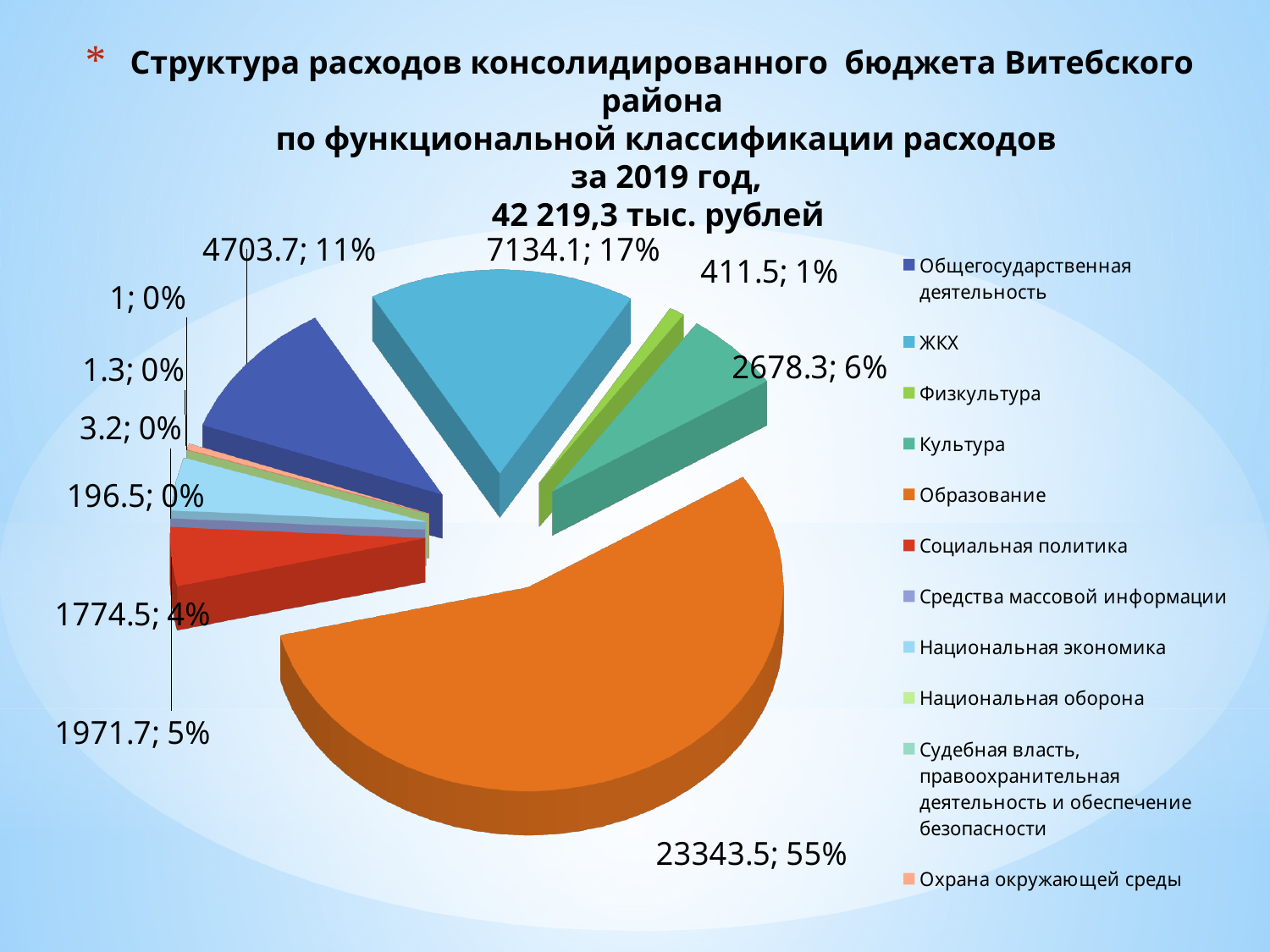
How many categories does the legend of the pie chart list? 11 What kind of chart is shown on the slide? Pie chart What is the difference between the values for ЖКХ and Общегосударственная деятельность? 2430.4 What value is shown for Культура? 2678.3 Which category has the largest slice of the pie chart? Образование What value is shown for Образование? 23343.5 What share of the pie does ЖКХ account for? 17% What value is shown for Общегосударственная деятельность? 4703.7 What share of the pie does Образование account for? 55% According to the chart title, what is the total expenditure of the consolidated budget for 2019? 42 219,3 тыс. рублей What value is shown for ЖКХ? 7134.1 Which is larger, the value for ЖКХ or the value for Общегосударственная деятельность? ЖКХ